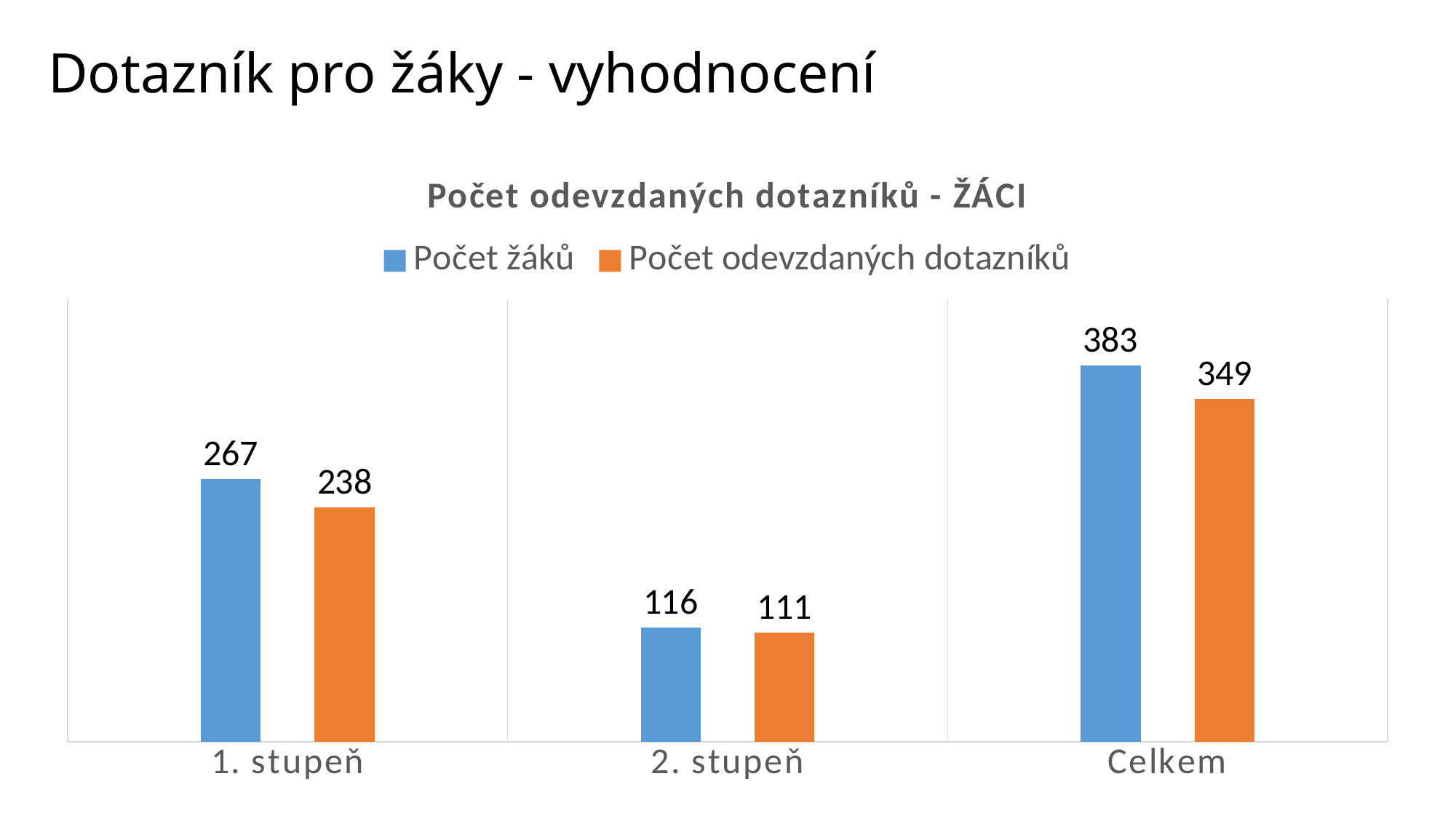
Which category has the lowest value for Počet žáků? 2. stupeň Which category has the highest value for Počet odevzdaných dotazníků? Celkem What is the value of Počet žáků for 1. stupeň? 267 What is the value of Počet žáků for Celkem? 383 How many categories are shown on the x axis? 3 What is the value of Počet odevzdaných dotazníků for 1. stupeň? 238 Which is larger: Počet žáků for 1. stupeň or Počet odevzdaných dotazníků for Celkem? Počet odevzdaných dotazníků for Celkem What is the difference between Počet žáků and Počet odevzdaných dotazníků for 1. stupeň? 29 What is the value of Počet odevzdaných dotazníků for 2. stupeň? 111 What type of chart is shown on the slide? Bar chart What is the difference between Počet žáků and Počet odevzdaných dotazníků for Celkem? 34 How many series does the legend list? 2